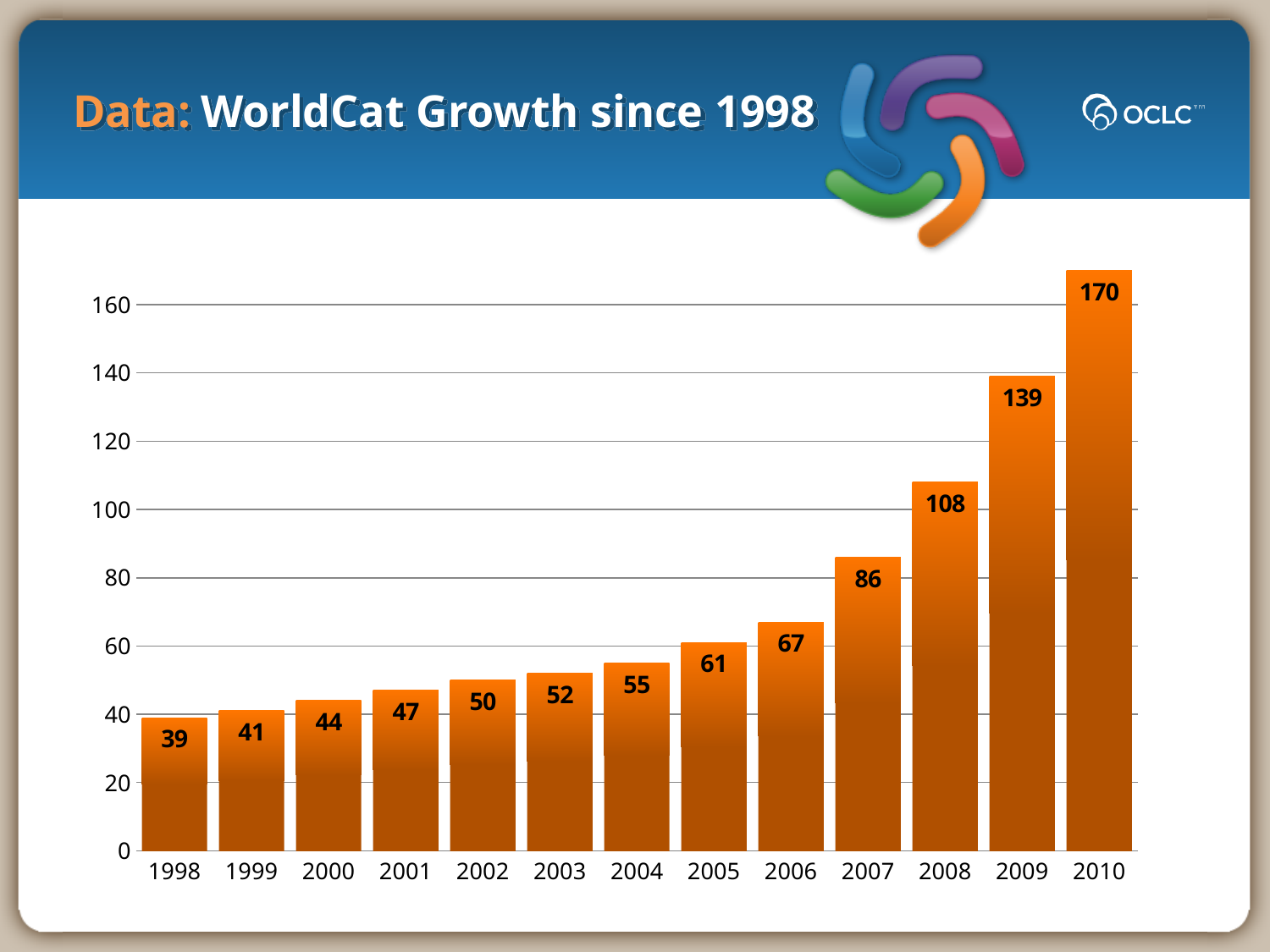
What is the value for 1998? 39 What is the difference between the values for 2010 and 2009? 31 What is the value for 2007? 86 Which is larger, the value for 2005 or the value for 2006? 2006 How many years are shown on the x axis? 13 Which year has the highest value? 2010 What is the difference between the values for 2008 and 1998? 69 Which year has the lowest value? 1998 Do the values rise or fall from 1998 to 2010? rise Is the value for 2009 greater or less than 120? greater What kind of chart is shown on the slide? bar chart What is the value for 2010? 170